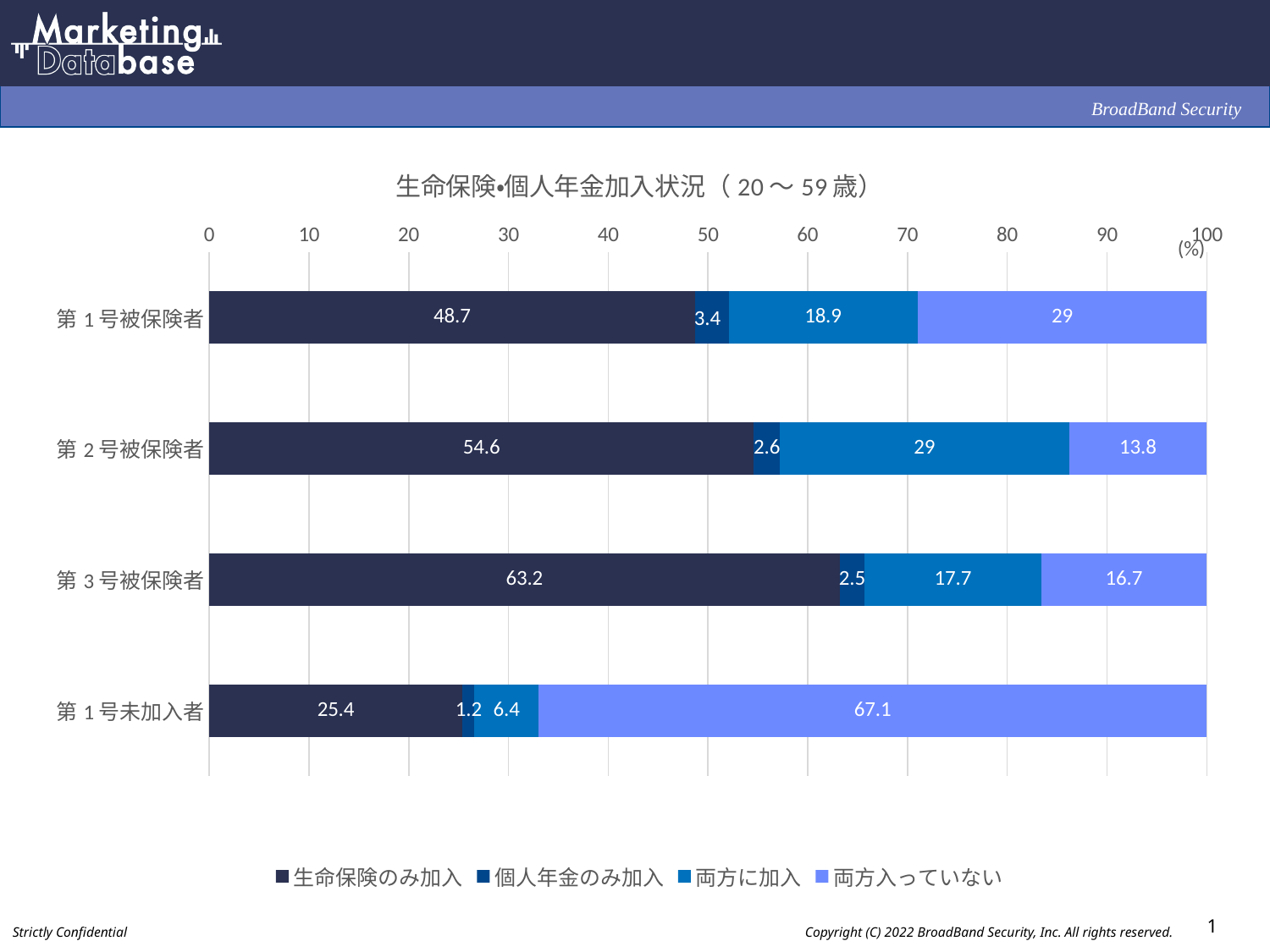
What is the value of 両方入っていない for 第1号未加入者? 67.1 Which is larger: 両方入っていない for 第1号被保険者 or for 第3号被保険者? 第1号被保険者 What is the value of 生命保険のみ加入 for 第3号被保険者? 63.2 What type of chart is shown on the slide? Stacked bar chart What is the difference between the 生命保険のみ加入 values for 第2号被保険者 and 第1号被保険者? 5.9 How many categories are plotted on the chart? 4 Which category has the highest value for 生命保険のみ加入? 第3号被保険者 How many series does the legend list? 4 What is the value of 個人年金のみ加入 for 第1号被保険者? 3.4 Which category has the lowest value for 両方に加入? 第1号未加入者 What is the title of the chart? 生命保険•個人年金加入状況（20～59歳） What is the value of 両方に加入 for 第2号被保険者? 29